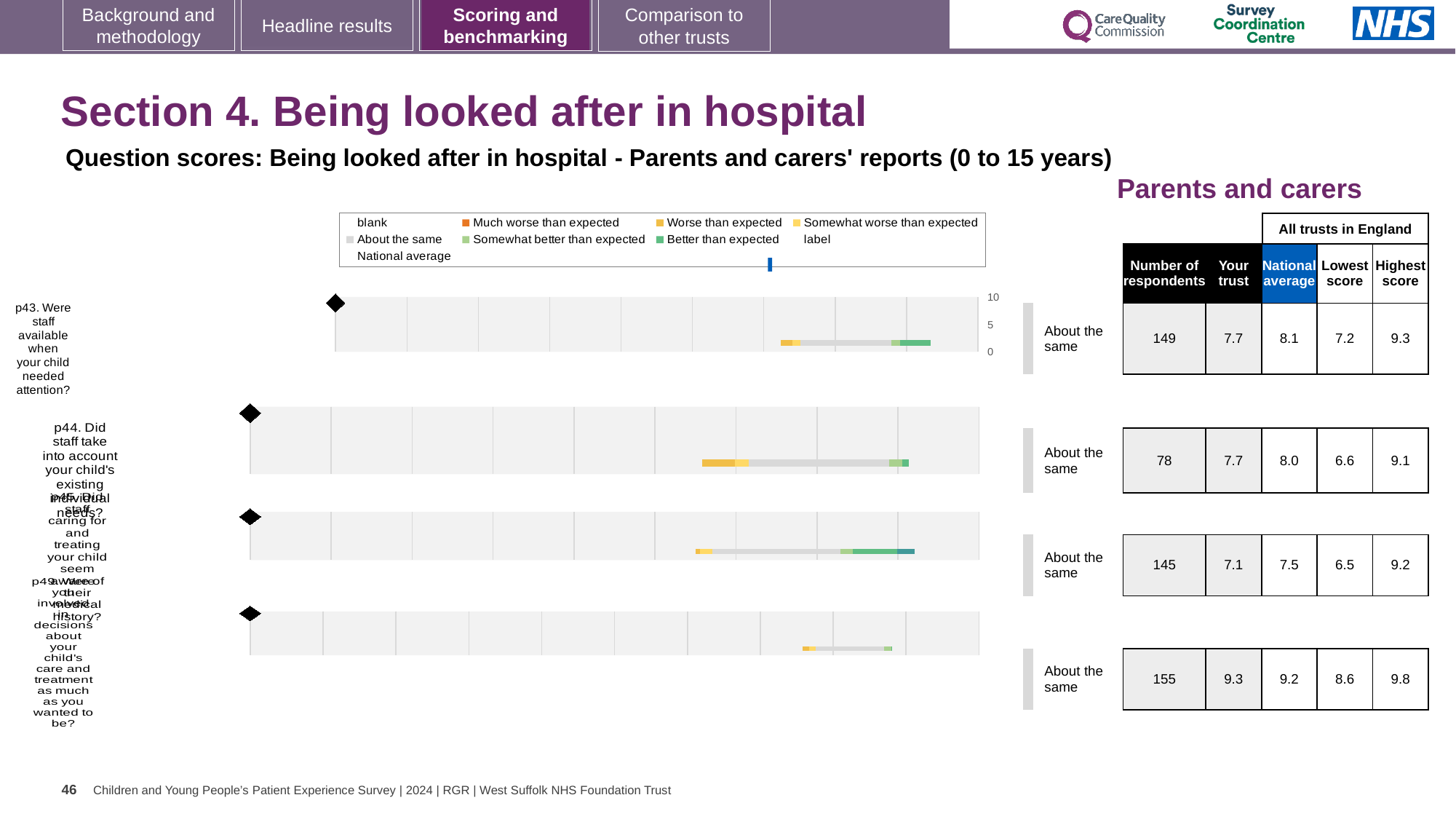
For question p49, which is larger: the 'Your trust' score or the national average? Your trust What kind of chart is used to show the question scores on this slide? bar chart For question p43, what is the difference between the national average and the 'Your trust' score? 0.4 Which question has the highest 'Your trust' score? p49 How many respondents answered question p49 (Were you involved in decisions about your child's care and treatment?)? 155 What is the 'Your trust' score for question p43 (Were staff available when your child needed attention?)? 7.7 What is the highest score among all trusts in England for question p44? 9.1 How many questions (chart rows) are plotted on the slide? 4 Which question has the lowest 'Your trust' score? p45 What is the national average score for question p45 (Did staff seem aware of your child's medical history?)? 7.5 Is the 'Your trust' score for question p43 greater or less than 5 on the chart axis? greater What benchmark category is shown for all four questions on this slide? About the same